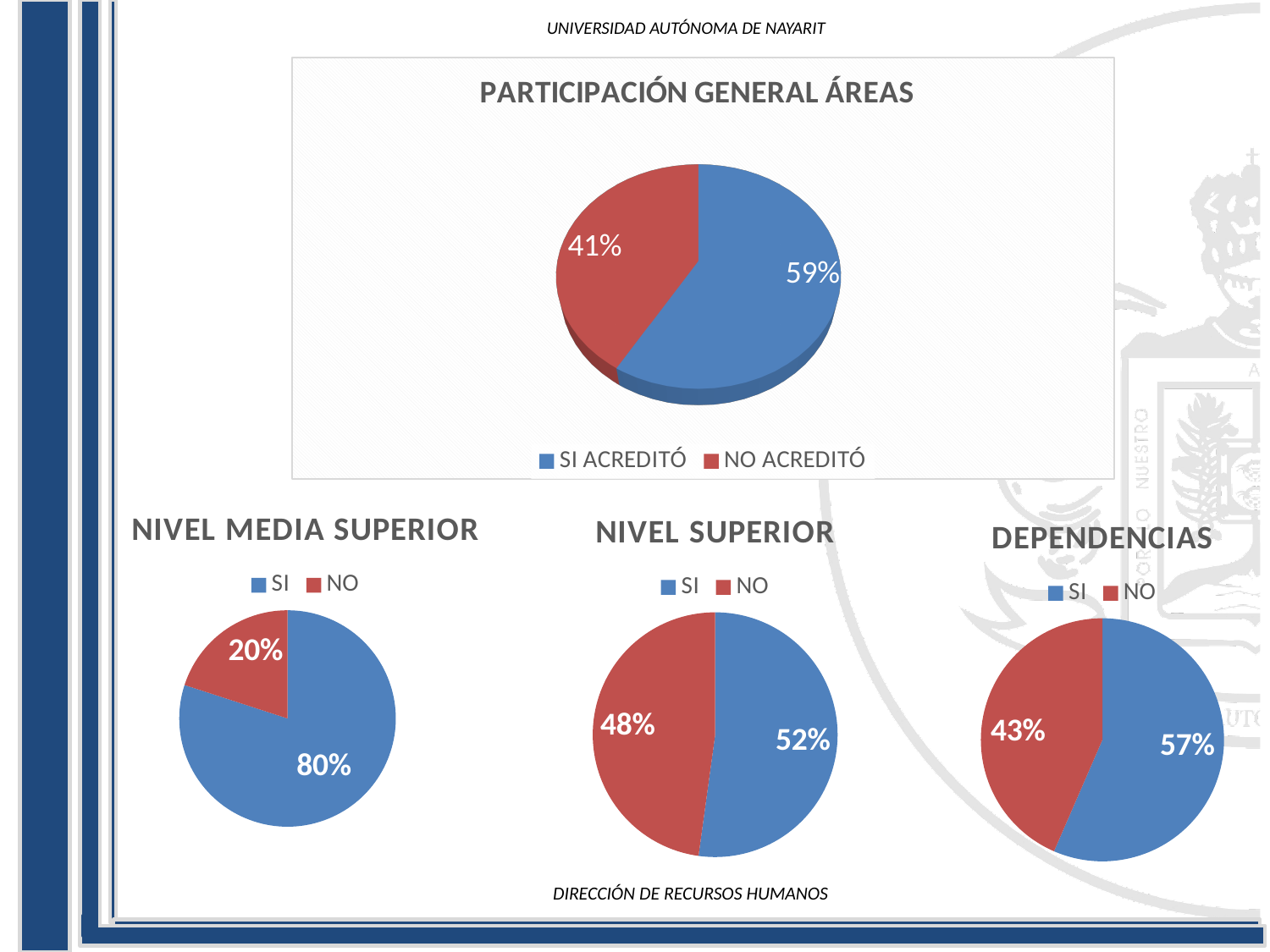
In the PARTICIPACIÓN GENERAL ÁREAS chart, what percentage is shown for NO ACREDITÓ? 41% In the NIVEL SUPERIOR chart, what percentage is shown for NO? 48% In the NIVEL MEDIA SUPERIOR chart, what percentage is shown for SI? 80% In the DEPENDENCIAS chart, what percentage is shown for SI? 57% In the PARTICIPACIÓN GENERAL ÁREAS chart, what colour is the SI ACREDITÓ slice? Blue How many slices does the DEPENDENCIAS chart have? 2 What kind of chart is the NIVEL SUPERIOR chart? Pie chart In the DEPENDENCIAS chart, which slice is larger, SI or NO? SI In the NIVEL MEDIA SUPERIOR chart, what is the difference between the SI and NO percentages? 60% In the PARTICIPACIÓN GENERAL ÁREAS chart, what percentage is shown for SI ACREDITÓ? 59% In the PARTICIPACIÓN GENERAL ÁREAS chart, what is the difference between SI ACREDITÓ and NO ACREDITÓ? 18% In the NIVEL MEDIA SUPERIOR chart, what percentage is shown for NO? 20%